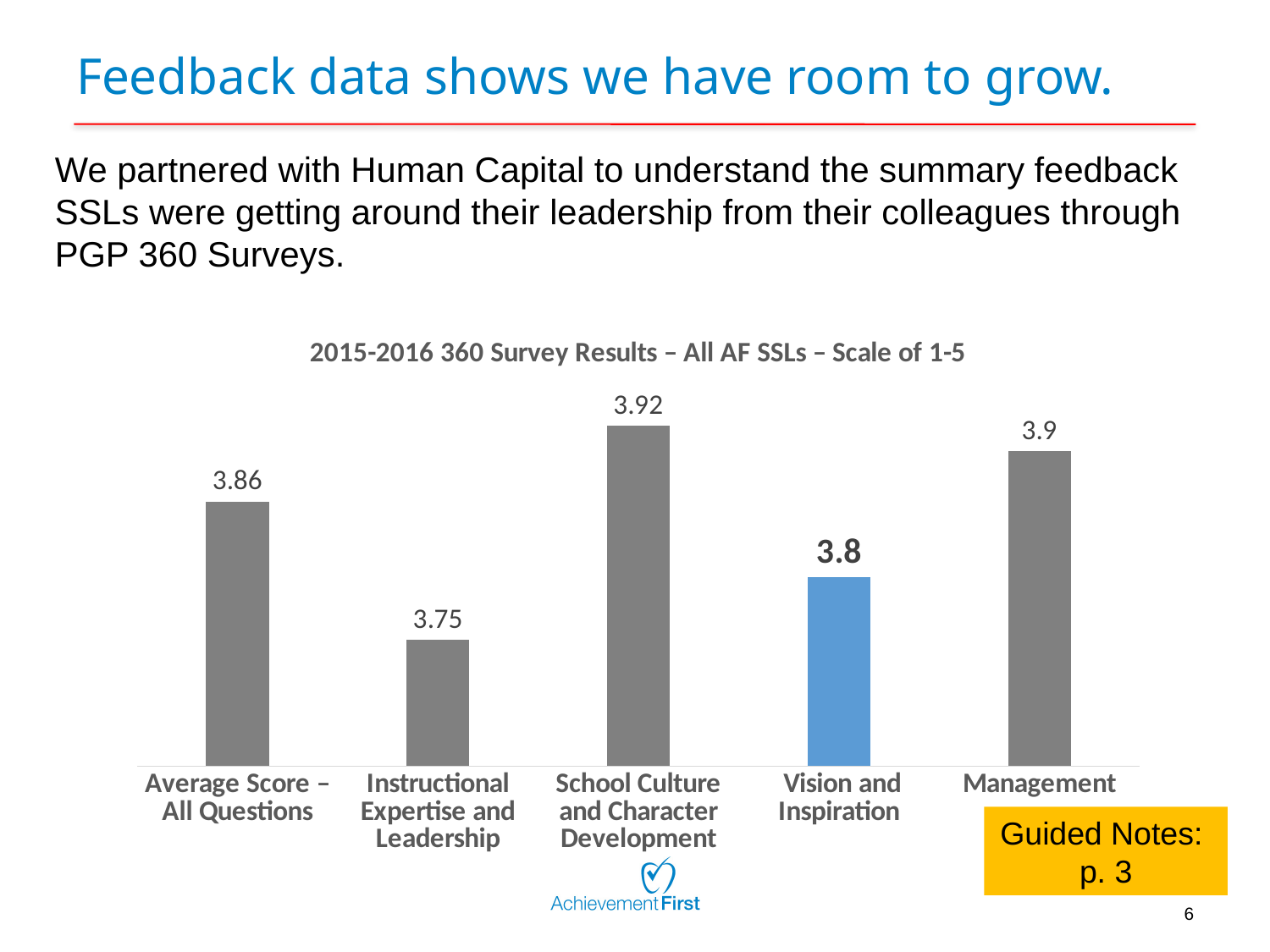
How many categories are shown in the chart? 5 What is the value for Vision and Inspiration? 3.8 Which is larger, the value for Management or the value for Vision and Inspiration? Management What is the value for Instructional Expertise and Leadership? 3.75 What is the value for School Culture and Character Development? 3.92 What kind of chart is shown on the slide? Bar chart What is the value for Management? 3.9 Which category has the lowest value? Instructional Expertise and Leadership Which bar is highlighted in blue? Vision and Inspiration What is the value for Average Score – All Questions? 3.86 Which category has the highest value? School Culture and Character Development What is the difference between the values for School Culture and Character Development and Instructional Expertise and Leadership? 0.17